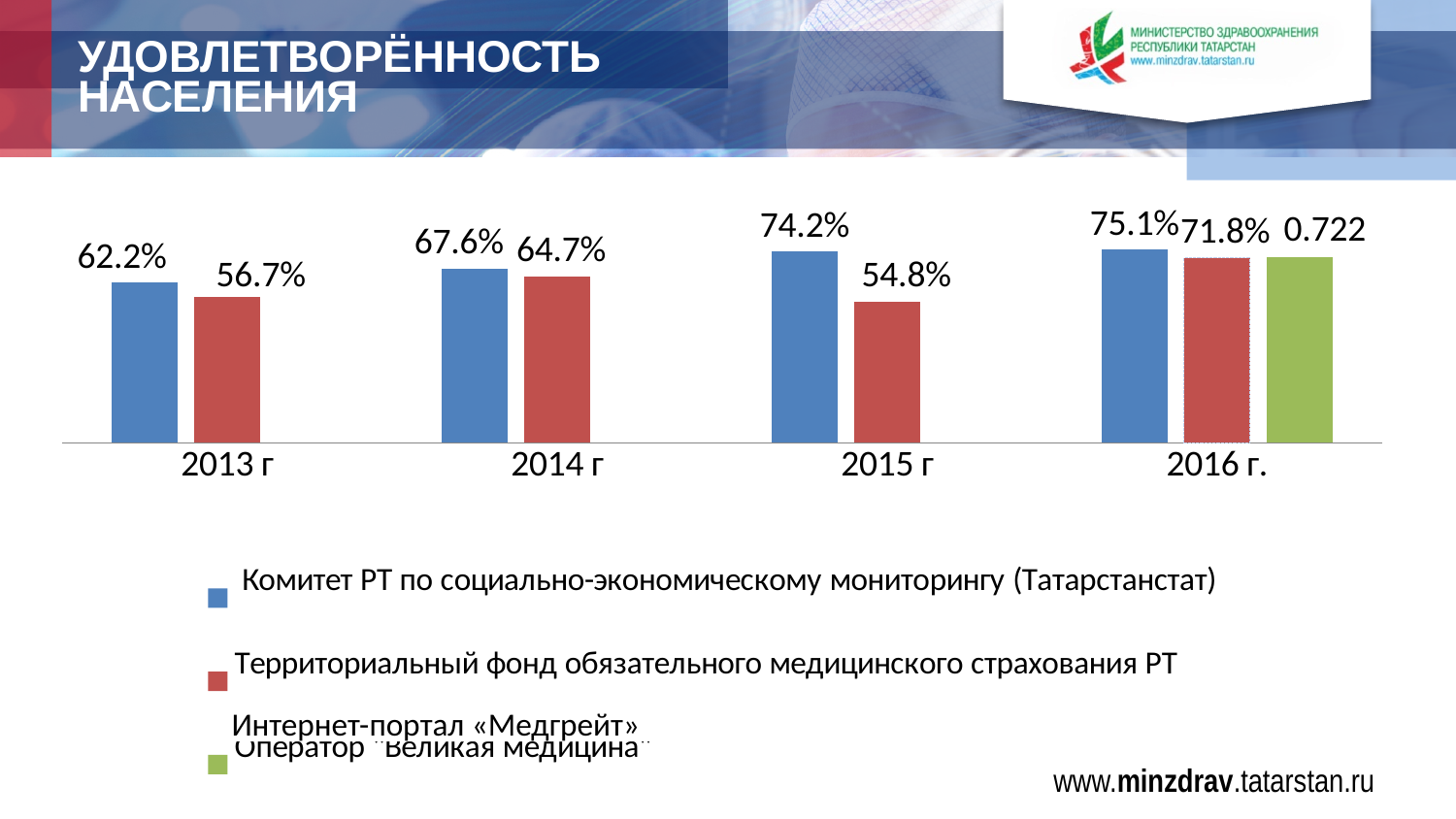
In which year is the blue series (Татарстанстат) highest? 2016 г. What is the difference between the blue and red values in 2015 г? 19.4 percentage points How many series does the legend list? 3 What value is shown for the green bar in 2016 г.? 0.722 In which year is the red series (Территориальный фонд ОМС РТ) lowest? 2015 г Does the blue series (Татарстанстат) rise or fall from 2013 г to 2016 г.? Rises What is the value of the red series (Территориальный фонд обязательного медицинского страхования РТ) for 2015 г? 54.8% Which is larger in 2013 г: the blue series value or the red series value? The blue series (62.2%) What is the value of the red series for 2014 г? 64.7% How many year categories are shown on the x axis? 4 What kind of chart is shown on the slide? Bar chart What is the value of the blue series (Комитет РТ по социально-экономическому мониторингу) for 2013 г? 62.2%